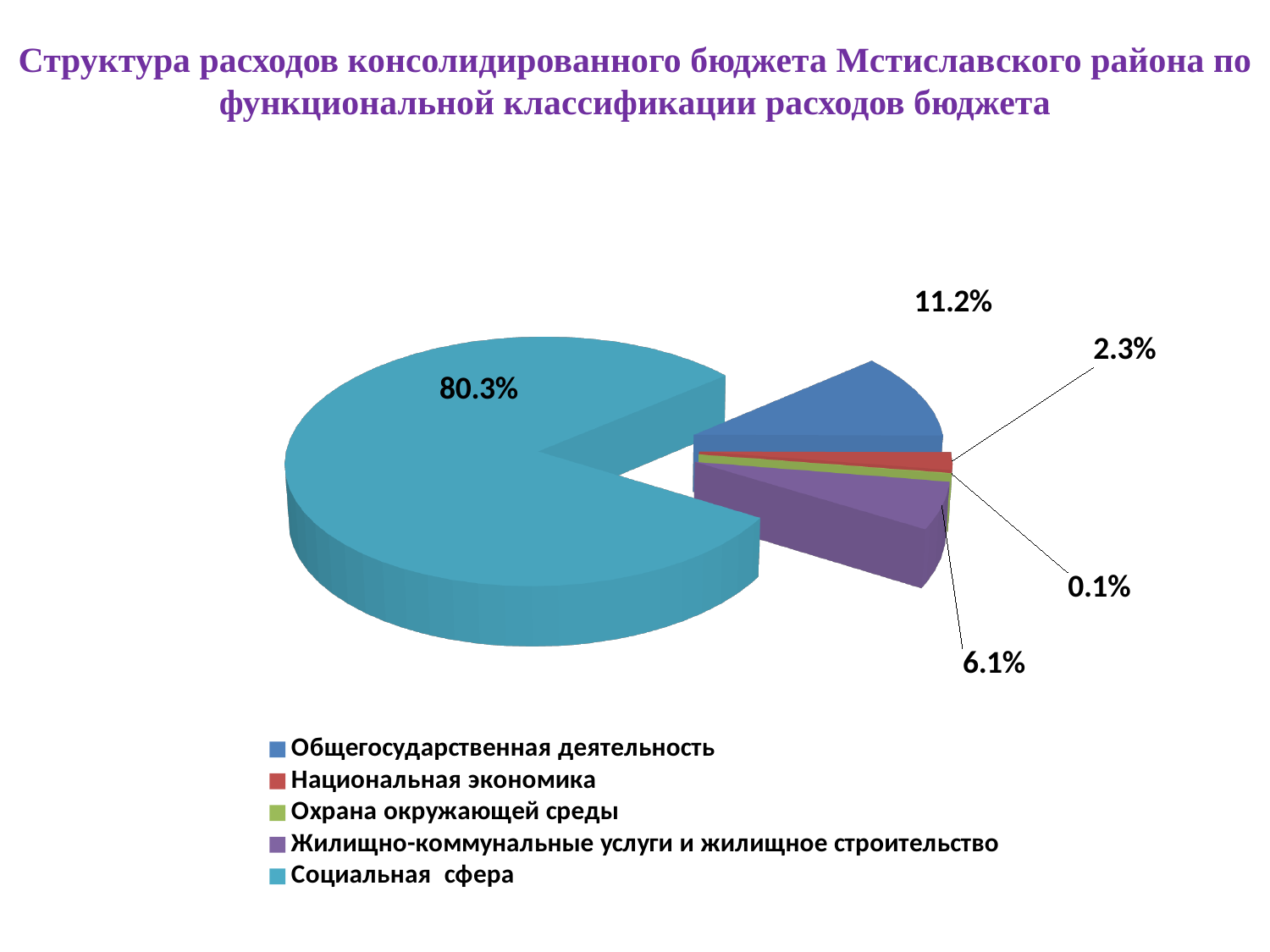
Which category has the smallest share of the pie? Охрана окружающей среды What is the value shown for Жилищно-коммунальные услуги и жилищное строительство? 6.1% What colour is the slice for Социальная сфера? Teal (light blue) What type of chart is shown on the slide? Pie chart What is the value shown for Общегосударственная деятельность? 11.2% What is the value shown for Национальная экономика? 2.3% Which category has the largest share of the pie? Социальная сфера What share of expenditures does Социальная сфера account for? 80.3% What is the value shown for Охрана окружающей среды? 0.1% Which is larger: the share of Национальная экономика or the share of Жилищно-коммунальные услуги и жилищное строительство? Жилищно-коммунальные услуги и жилищное строительство How many categories does the legend list? 5 What is the difference between the shares of Общегосударственная деятельность and Жилищно-коммунальные услуги и жилищное строительство? 5.1%